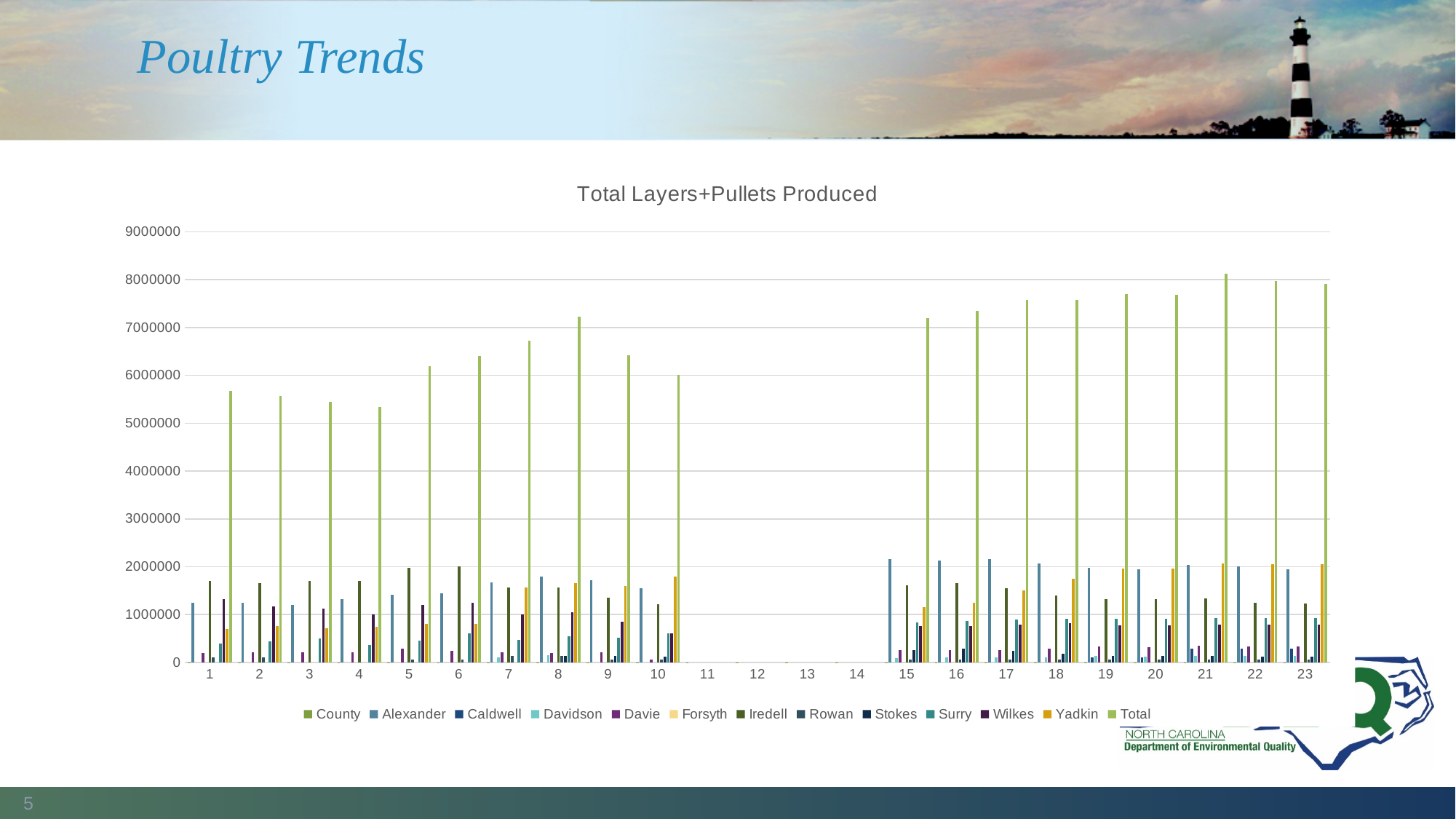
Is the Total value for category 21 greater or less than 8000000? greater Is the Total value for category 1 greater or less than 5000000? greater What kind of chart is shown on the slide? Bar chart What is the title of the chart? Total Layers+Pullets Produced Is the Total value for category 4 greater or less than 6000000? less Do the Total values generally rise or fall from category 15 to category 21? Rise How many categories are shown along the x axis? 23 How many series does the legend list? 13 Which series is listed last in the legend? Total Which is larger, the Total value for category 8 or the Total value for category 9? Category 8